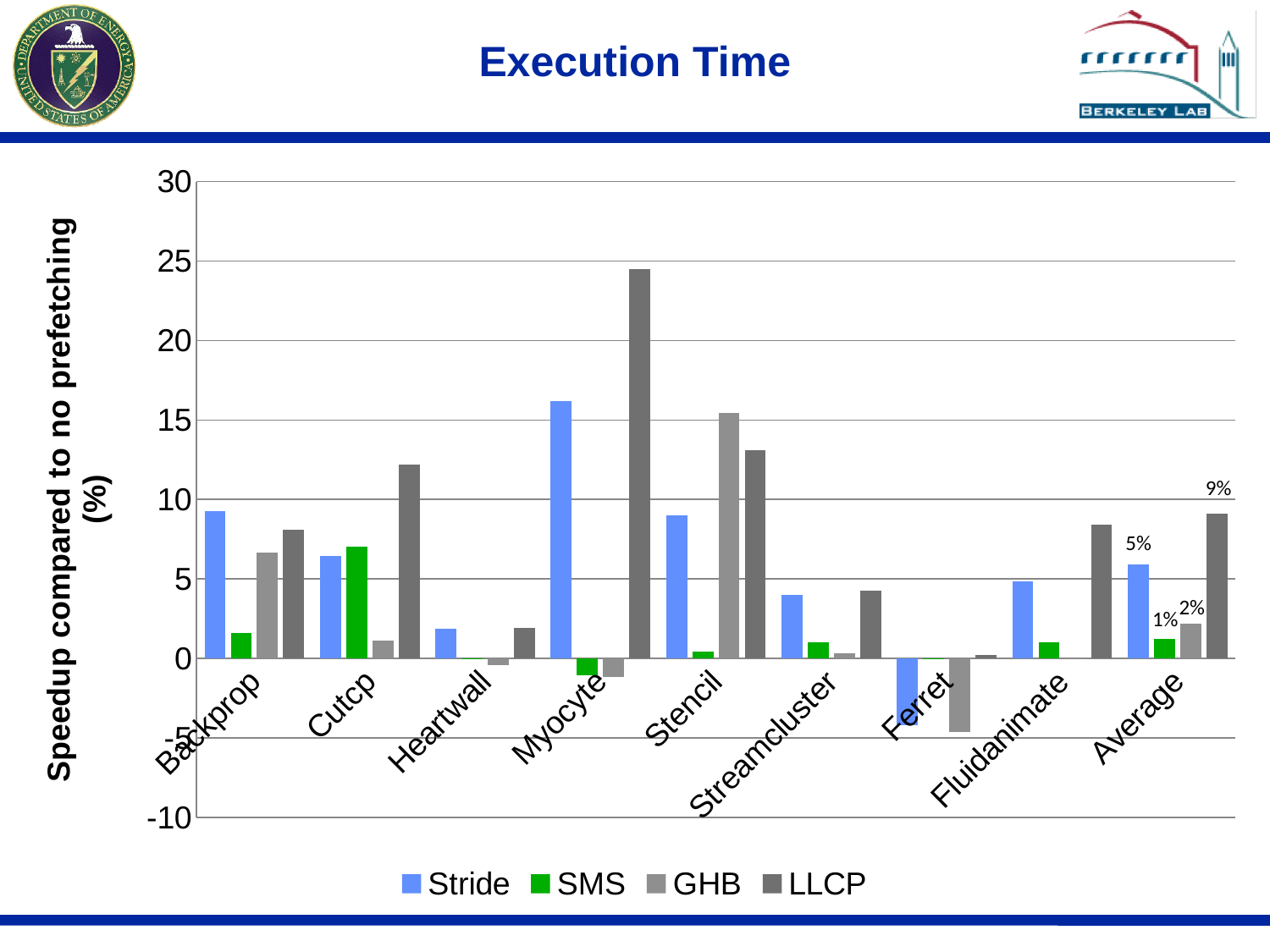
How many categories are shown along the x axis? 9 What is the LLCP value for Average? 9% What is the GHB value for Average? 2% Which series has the lowest value for Average? SMS What kind of chart is shown on the slide? bar chart What is the Stride value for Average? 5% What is the title of the y axis? Speedup compared to no prefetching (%) Which category has the tallest LLCP bar? Myocyte Which series has the highest value for Average? LLCP Is the LLCP value for Myocyte greater or less than 20? greater How many series does the legend list? 4 What is the difference between the LLCP and Stride values for Average? 4%